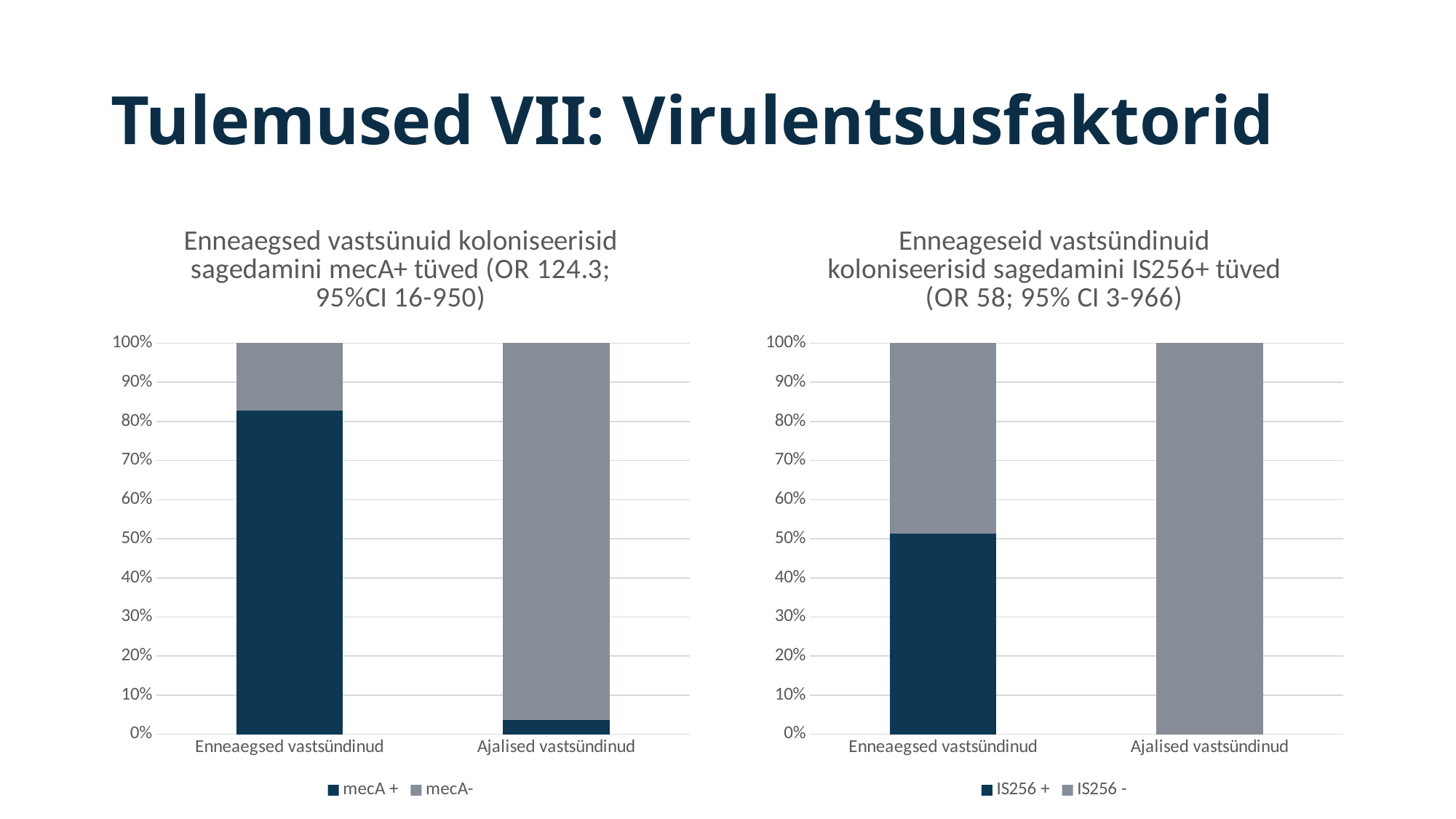
How many series does the legend of the left chart (mecA) list? 2 What are the two legend entries of the right chart? IS256 + and IS256 - What odds ratio is given in the title of the left chart? OR 124.3 In the left chart (mecA), which category has the larger mecA + share, Enneaegsed vastsündinud or Ajalised vastsündinud? Enneaegsed vastsündinud How many categories are shown on the x axis of the right chart (IS256)? 2 What kind of chart is the left chart (mecA)? stacked bar chart In the right chart (IS256), which category has the larger IS256 + share, Enneaegsed vastsündinud or Ajalised vastsündinud? Enneaegsed vastsündinud In the right chart (IS256), is the IS256 + share for Enneaegsed vastsündinud greater or less than 40%? greater In the right chart (IS256), what is the IS256 - share for Ajalised vastsündinud? 100% In the left chart (mecA), is the mecA + share for Enneaegsed vastsündinud greater or less than 70%? greater In the left chart (mecA), is the mecA + share for Ajalised vastsündinud greater or less than 10%? less In the right chart (IS256), what is the total of the stacked bar for Enneaegsed vastsündinud? 100%